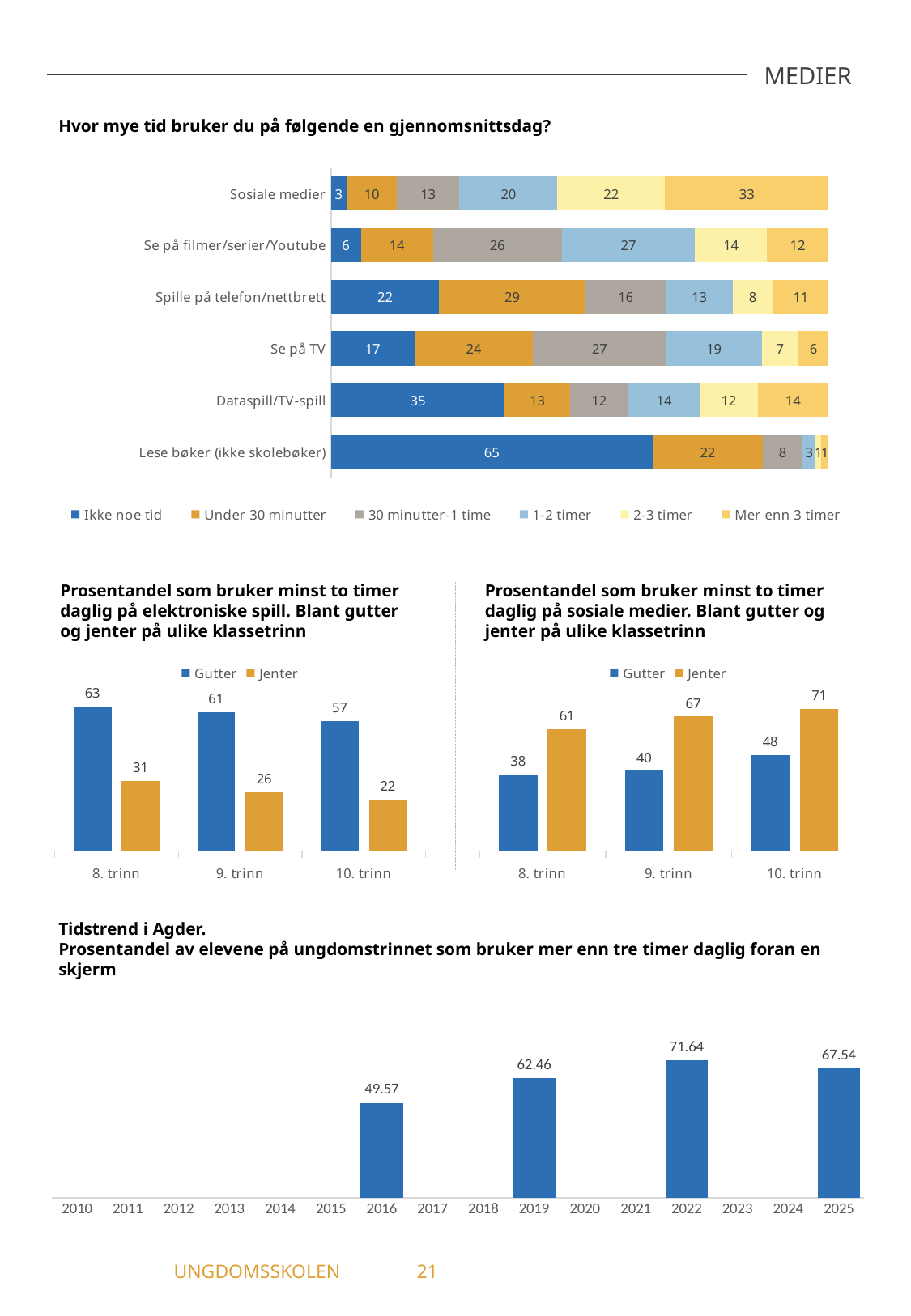
In the chart 'Prosentandel som bruker minst to timer daglig på elektroniske spill', what is the value for Jenter in 9. trinn? 26 In the chart 'Prosentandel som bruker minst to timer daglig på elektroniske spill', what is the difference between Gutter and Jenter in 8. trinn? 32 In the chart 'Prosentandel som bruker minst to timer daglig på sosiale medier', which group has the highest value in 10. trinn? Jenter In the chart 'Prosentandel som bruker minst to timer daglig på elektroniske spill', do the Gutter values rise or fall from 8. trinn to 10. trinn? fall In the chart 'Hvor mye tid bruker du på følgende en gjennomsnittsdag?', what is the value for 'Under 30 minutter' for Spille på telefon/nettbrett? 29 In the chart 'Prosentandel som bruker minst to timer daglig på sosiale medier', what is the value for Gutter in 9. trinn? 40 In the chart 'Hvor mye tid bruker du på følgende en gjennomsnittsdag?', what is the value for 'Mer enn 3 timer' for Sosiale medier? 33 In the chart 'Tidstrend i Agder', what is the value for 2022? 71.64 In the chart 'Tidstrend i Agder', what kind of chart is shown? bar chart In the chart 'Hvor mye tid bruker du på følgende en gjennomsnittsdag?', how many series does the legend list? 6 In the chart 'Hvor mye tid bruker du på følgende en gjennomsnittsdag?', which category has the highest value for 'Ikke noe tid'? Lese bøker (ikke skolebøker) In the chart 'Tidstrend i Agder', which year has the lowest value? 2016